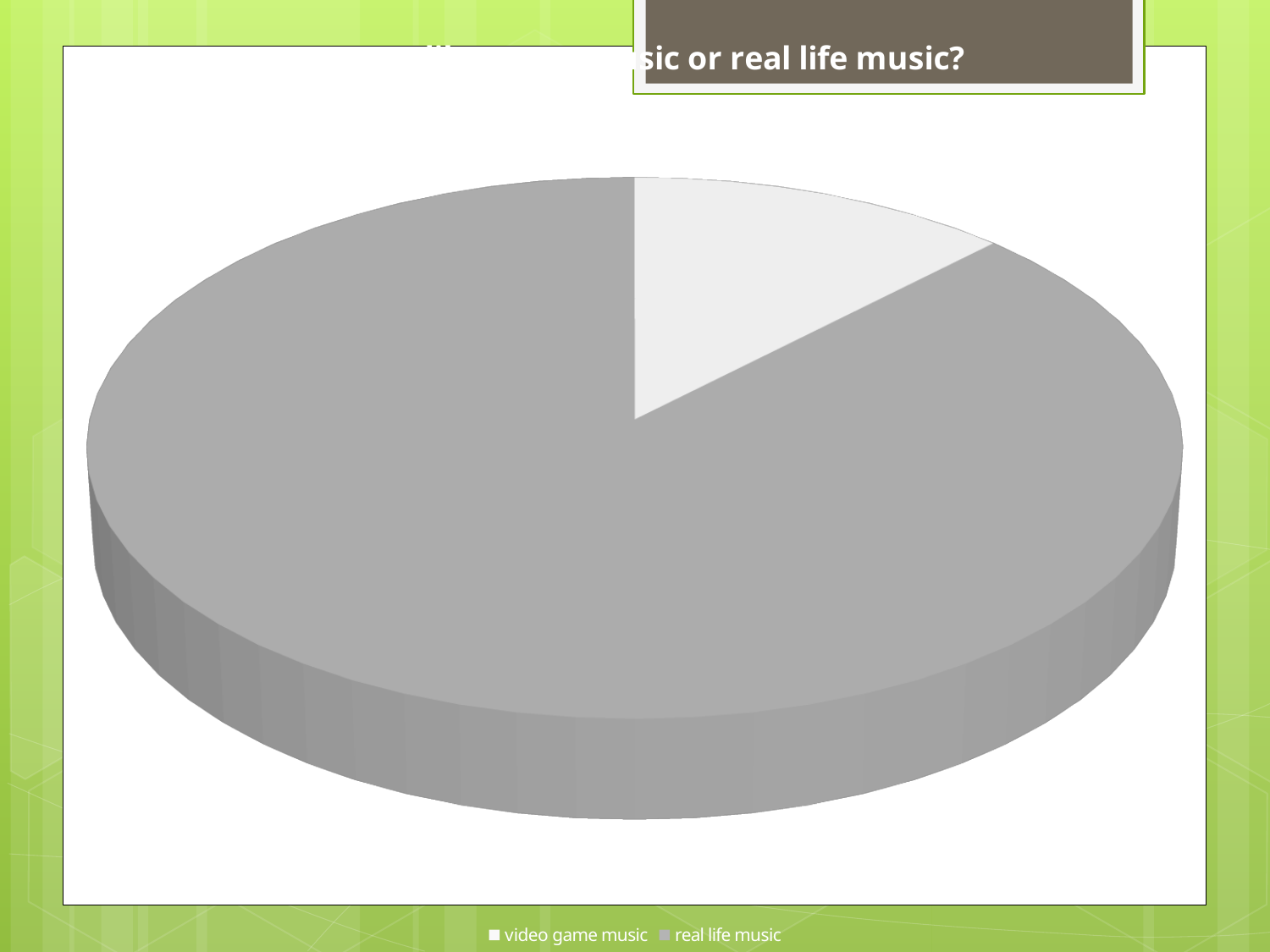
Which slice is larger, video game music or real life music? real life music What kind of chart is shown on the slide? pie chart How many slices does the pie chart have? 2 What are the two categories listed in the legend? video game music and real life music Which category has the smallest slice of the pie? video game music How many entries does the legend list? 2 Which legend entry is shown in the lighter colour? video game music Which category has the largest slice of the pie? real life music